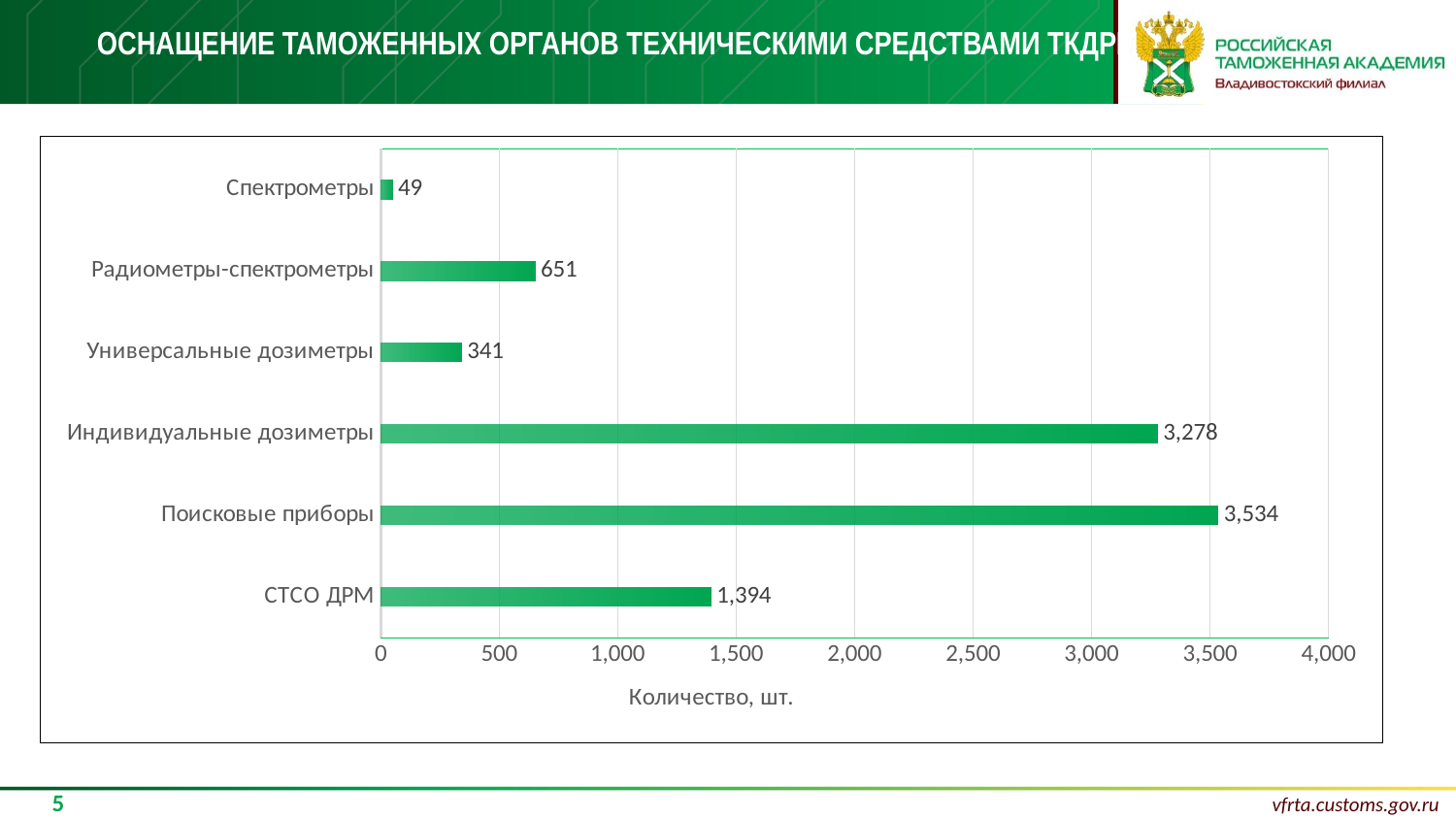
Is the value for СТСО ДРМ greater or less than 1,000? greater What is the difference between the values for Поисковые приборы and Индивидуальные дозиметры? 256 Which is larger, the value for Радиометры-спектрометры or the value for Универсальные дозиметры? Радиометры-спектрометры What is the value for Поисковые приборы? 3,534 What is the value for Спектрометры? 49 How many categories are shown in the chart? 6 What is the difference between the values for Радиометры-спектрометры and Универсальные дозиметры? 310 What kind of chart is shown on the slide? bar chart What is the label of the horizontal axis? Количество, шт. Which category has the lowest value? Спектрометры What is the value for СТСО ДРМ? 1,394 Which category has the highest value? Поисковые приборы